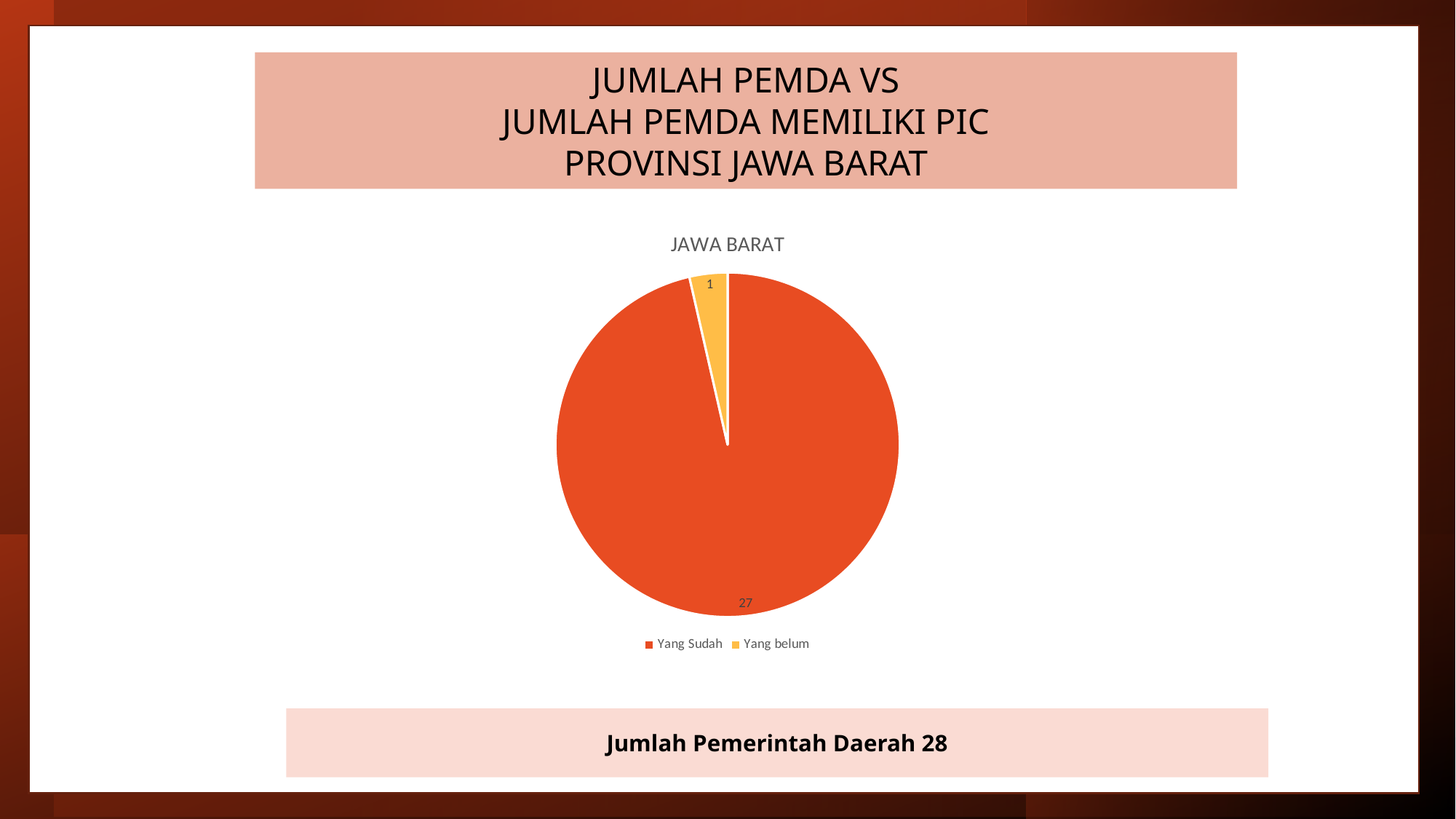
How many slices does the pie chart have? 2 What kind of chart is shown on the slide? pie chart What is the value for Yang belum? 1 What is the difference between the values for Yang Sudah and Yang belum? 26 What colour is the Yang belum slice? yellow Which is larger, Yang Sudah or Yang belum? Yang Sudah What is the total of all slices in the pie chart? 28 Which slice is the largest? Yang Sudah What is the value for Yang Sudah? 27 What is the chart's title? JAWA BARAT Which slice is the smallest? Yang belum How many entries does the legend list? 2